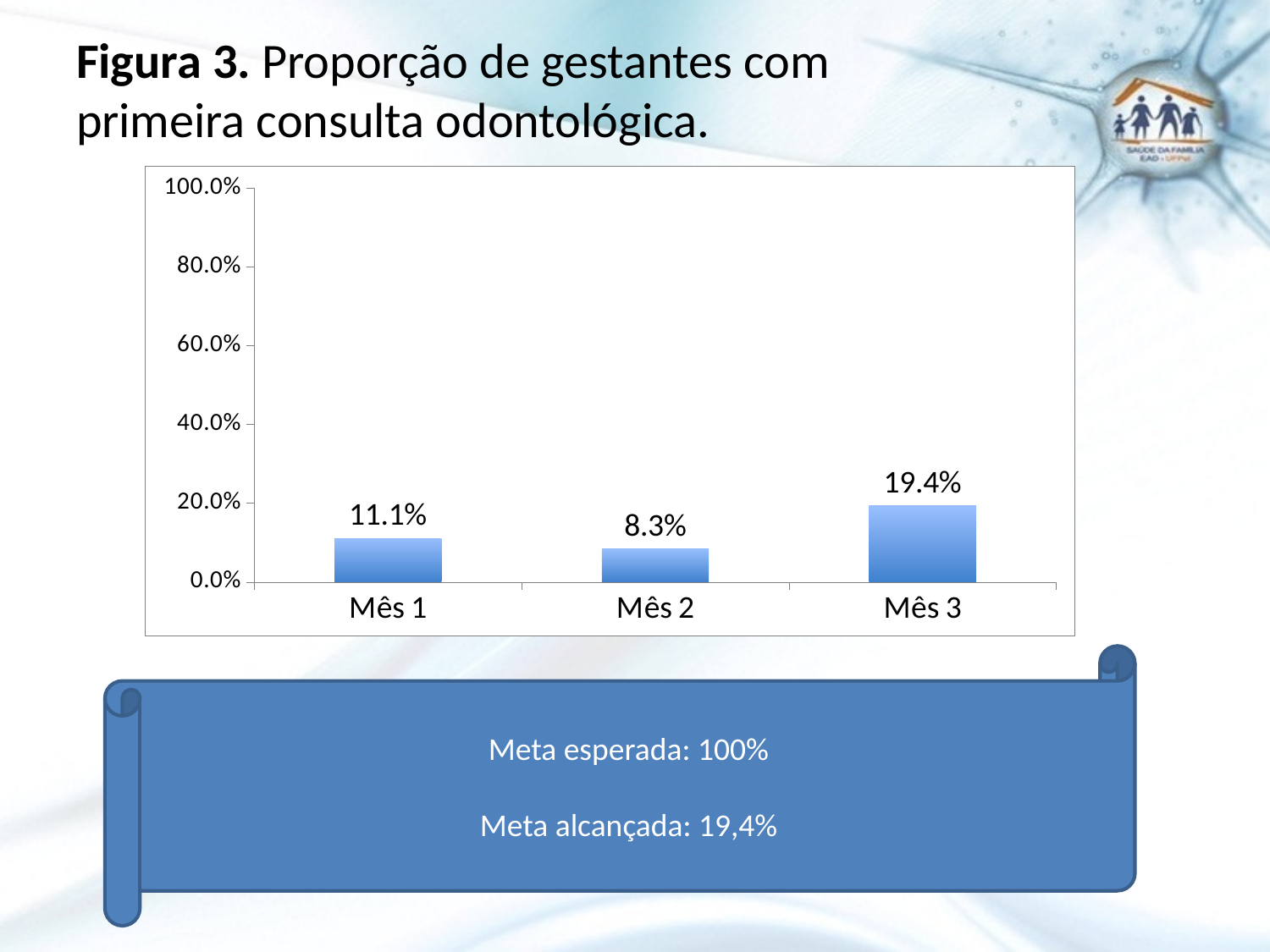
What is the value for Mês 1? 11.1% Which is larger, the value for Mês 1 or the value for Mês 2? Mês 1 Which month has the lowest value? Mês 2 What is the difference between the values for Mês 3 and Mês 1? 8.3% How many months are shown on the x axis? 3 What is the difference between the values for Mês 1 and Mês 2? 2.8% What kind of chart is shown on the slide? bar chart Is the value for Mês 3 greater or less than 20.0%? less What is the value for Mês 3? 19.4% Which month has the highest value? Mês 3 What is the value for Mês 2? 8.3% What is the highest value shown on the y axis? 100.0%